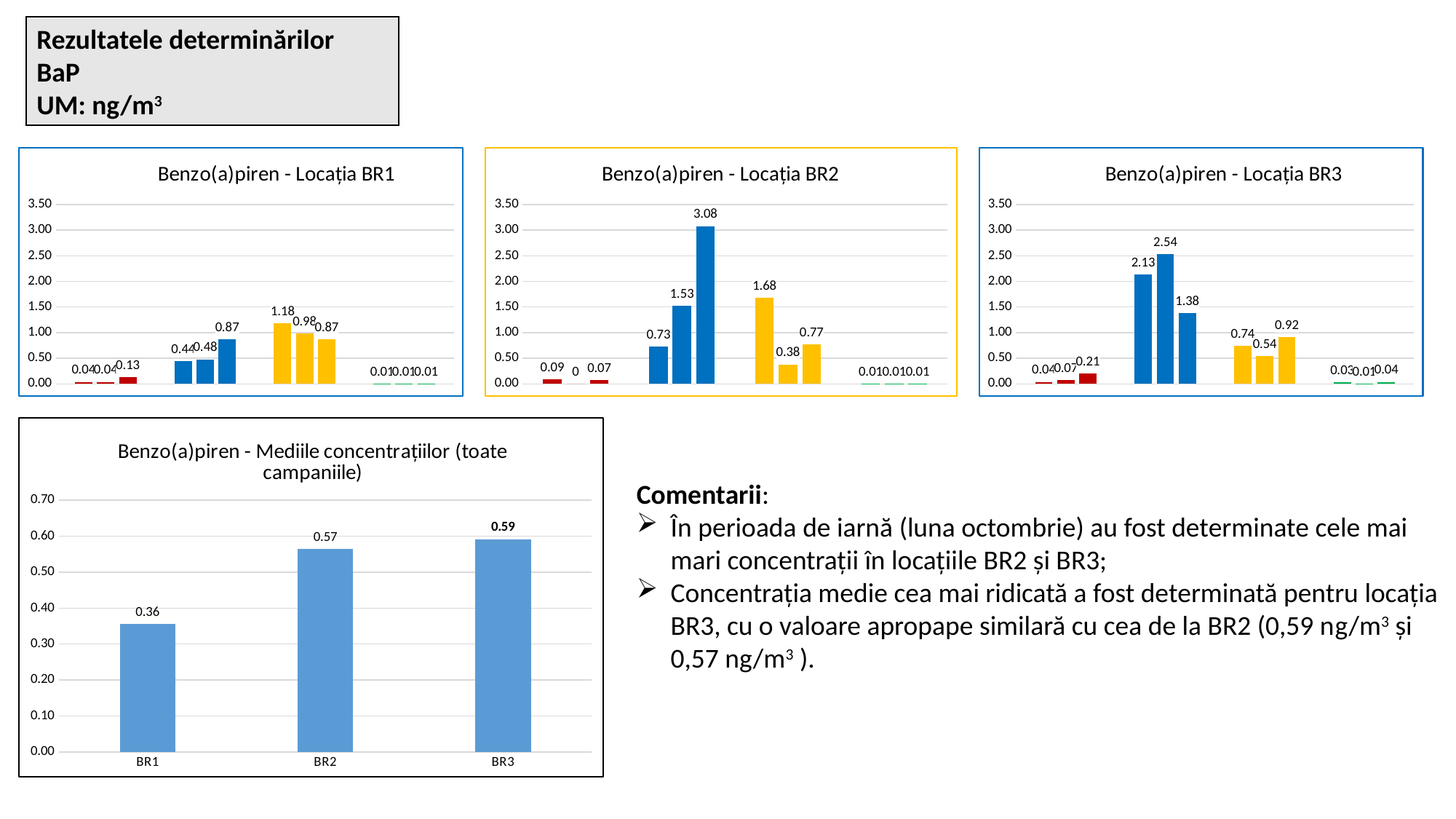
In the chart 'Benzo(a)piren - Mediile concentrațiilor (toate campaniile)', what is the value for BR1? 0.36 In the chart 'Benzo(a)piren - Locația BR1', what is the highest value labelled on any bar? 1.18 What kind of chart is 'Benzo(a)piren - Mediile concentrațiilor (toate campaniile)'? bar chart How many locations are shown in the chart 'Benzo(a)piren - Mediile concentrațiilor (toate campaniile)'? 3 In the chart 'Benzo(a)piren - Mediile concentrațiilor (toate campaniile)', which is larger, the value for BR1 or the value for BR2? BR2 In the chart 'Benzo(a)piren - Mediile concentrațiilor (toate campaniile)', what is the difference between the values for BR3 and BR1? 0.23 In the chart 'Benzo(a)piren - Locația BR2', what is the highest value labelled on any bar? 3.08 In the chart 'Benzo(a)piren - Mediile concentrațiilor (toate campaniile)', which location has the lowest value? BR1 In the chart 'Benzo(a)piren - Mediile concentrațiilor (toate campaniile)', what is the value for BR2? 0.57 In the chart 'Benzo(a)piren - Mediile concentrațiilor (toate campaniile)', do the values rise or fall from BR1 to BR3? rise In the chart 'Benzo(a)piren - Locația BR3', what is the highest value labelled on any bar? 2.54